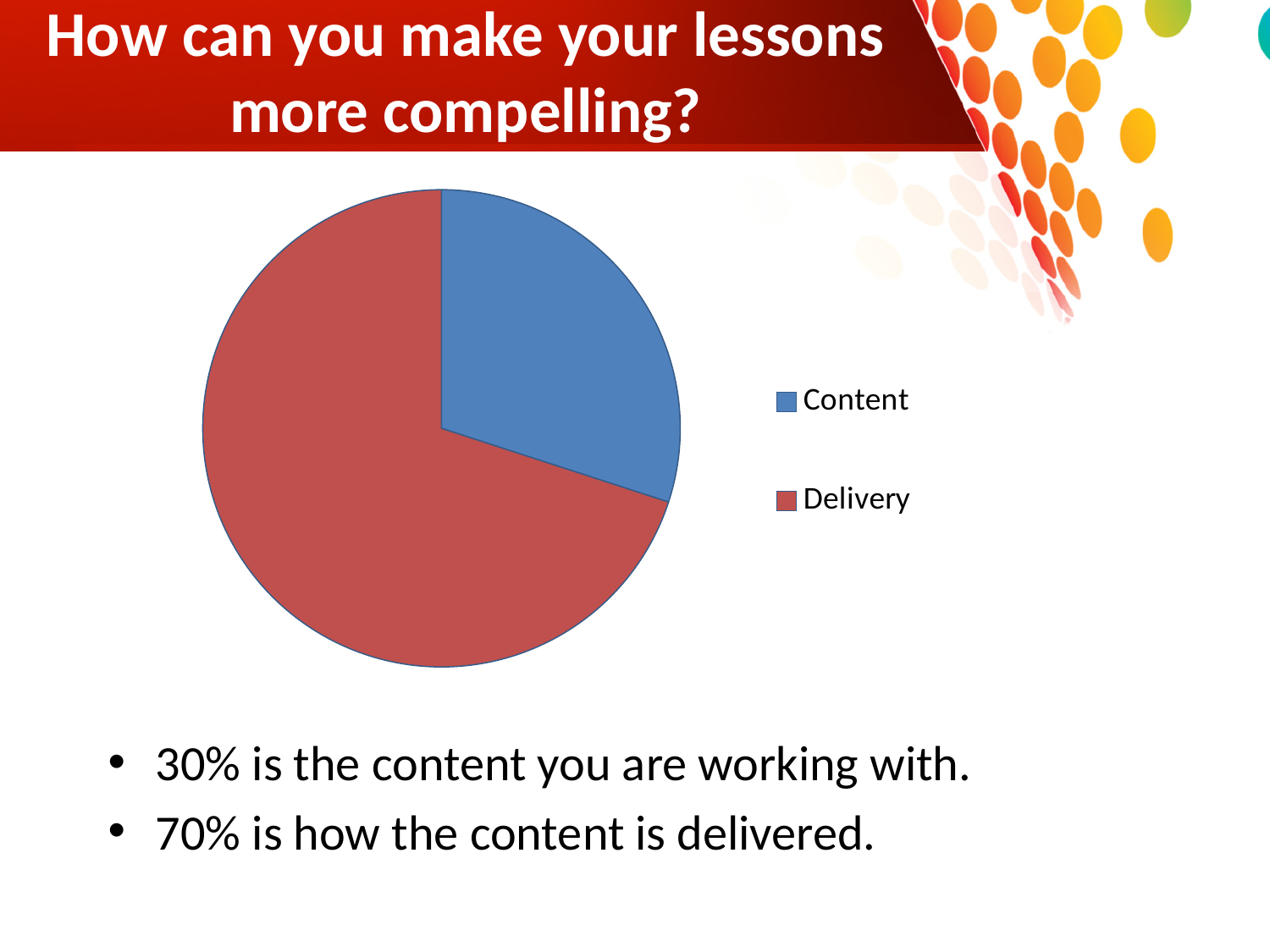
What colour is the Delivery slice in the pie chart? red How many entries does the legend of the pie chart list? 2 Is the Delivery slice greater or less than half of the pie? greater What share of the pie does the Content slice represent? 30% By how many percentage points does Delivery exceed Content in the pie chart? 40% What kind of chart is shown on the slide? pie chart Which slice of the pie chart is the largest? Delivery How many slices does the pie chart have? 2 What colour is the Content slice in the pie chart? blue What share of the pie does the Delivery slice represent? 70% Which slice of the pie chart is the smallest? Content Which is larger in the pie chart, Content or Delivery? Delivery